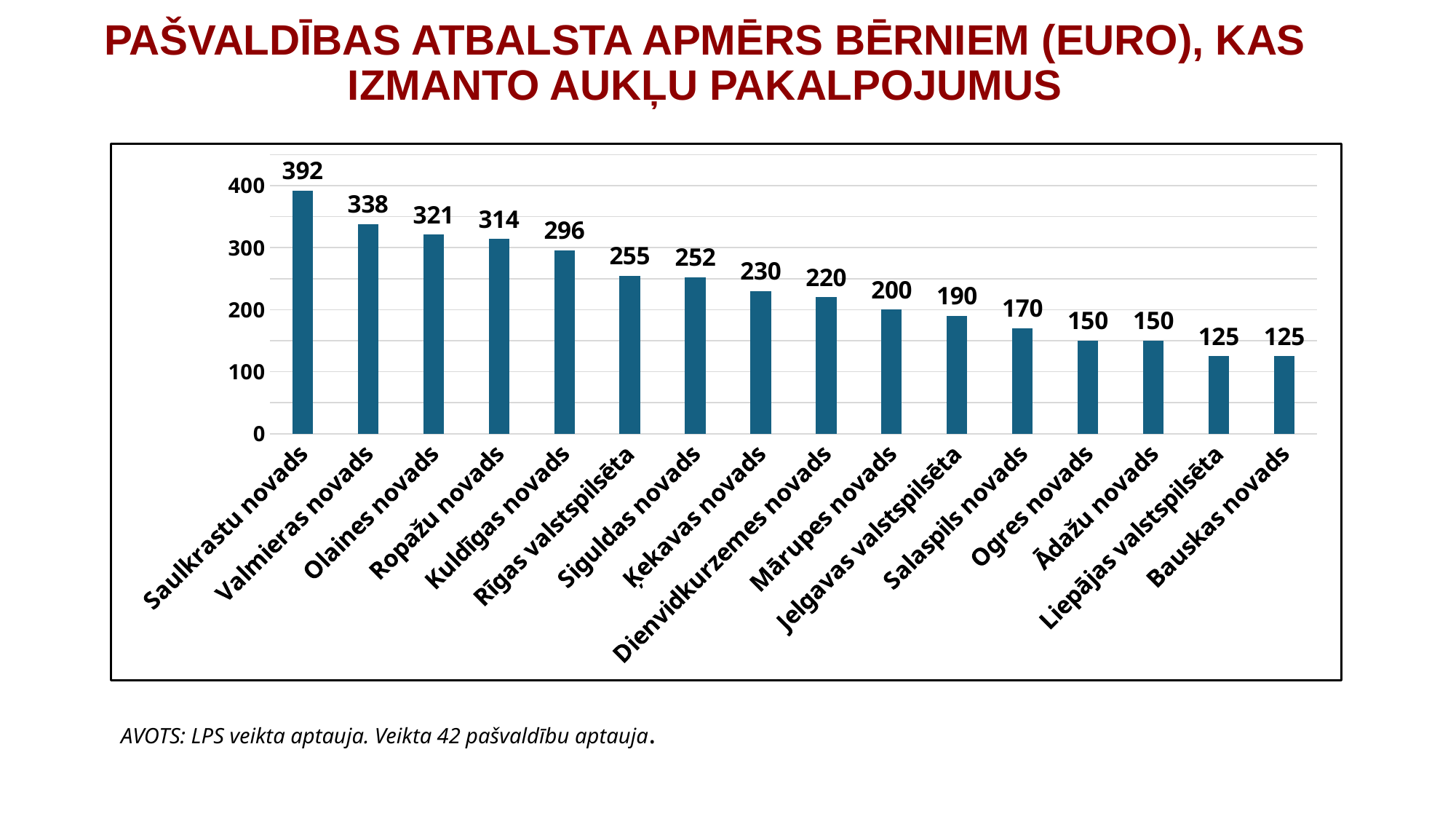
Do the values rise or fall from left to right along the x axis? fall Which is larger, the value for Kuldīgas novads or the value for Siguldas novads? Kuldīgas novads What is the value for Rīgas valstspilsēta? 255 What is the difference between the values for Valmieras novads and Olaines novads? 17 What is the difference between the values for Saulkrastu novads and Bauskas novads? 267 What is the value for Saulkrastu novads? 392 What kind of chart is shown on the slide? bar chart What is the value for Mārupes novads? 200 What is the value for Jelgavas valstspilsēta? 190 Which municipality has the highest value? Saulkrastu novads Is the value for Ķekavas novads greater or less than 200? greater How many municipalities are shown in the chart? 16